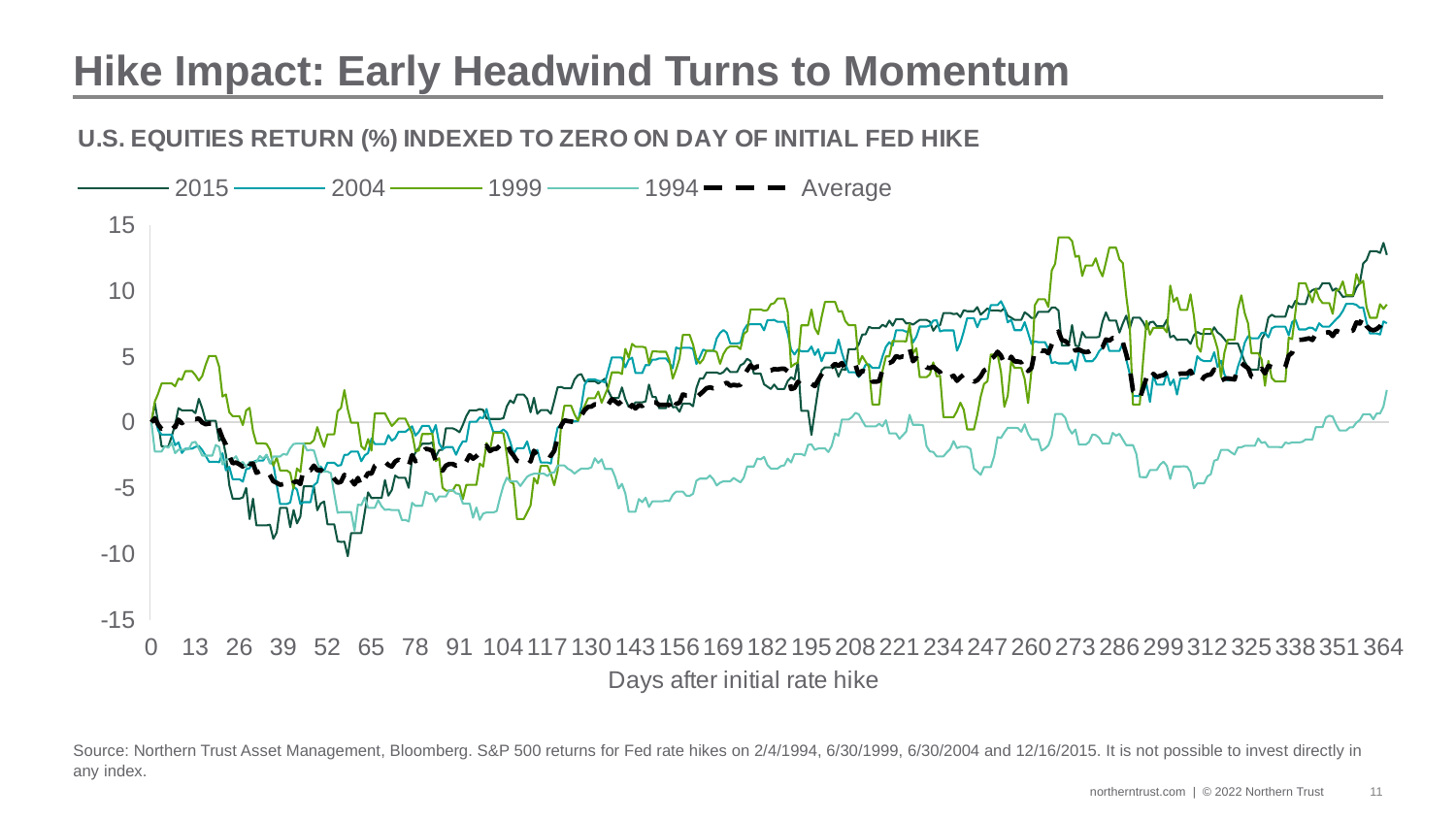
Which series ends highest at day 364? 2015 What is the label of the x axis? Days after initial rate hike Which series is drawn as a dashed black line? Average At day 364, which line is higher: 2015 or 1994? 2015 How many series does the legend list? 5 Is the value of the 1994 line at day 130 greater or less than 0? less Does the Average line rise or fall overall from day 0 to day 364? rise Is the value of the 2015 line at day 364 greater or less than 10? greater Is the value of the Average line at day 364 greater or less than 5? greater Which series ends lowest at day 364? 1994 What kind of chart is shown on the slide? line chart